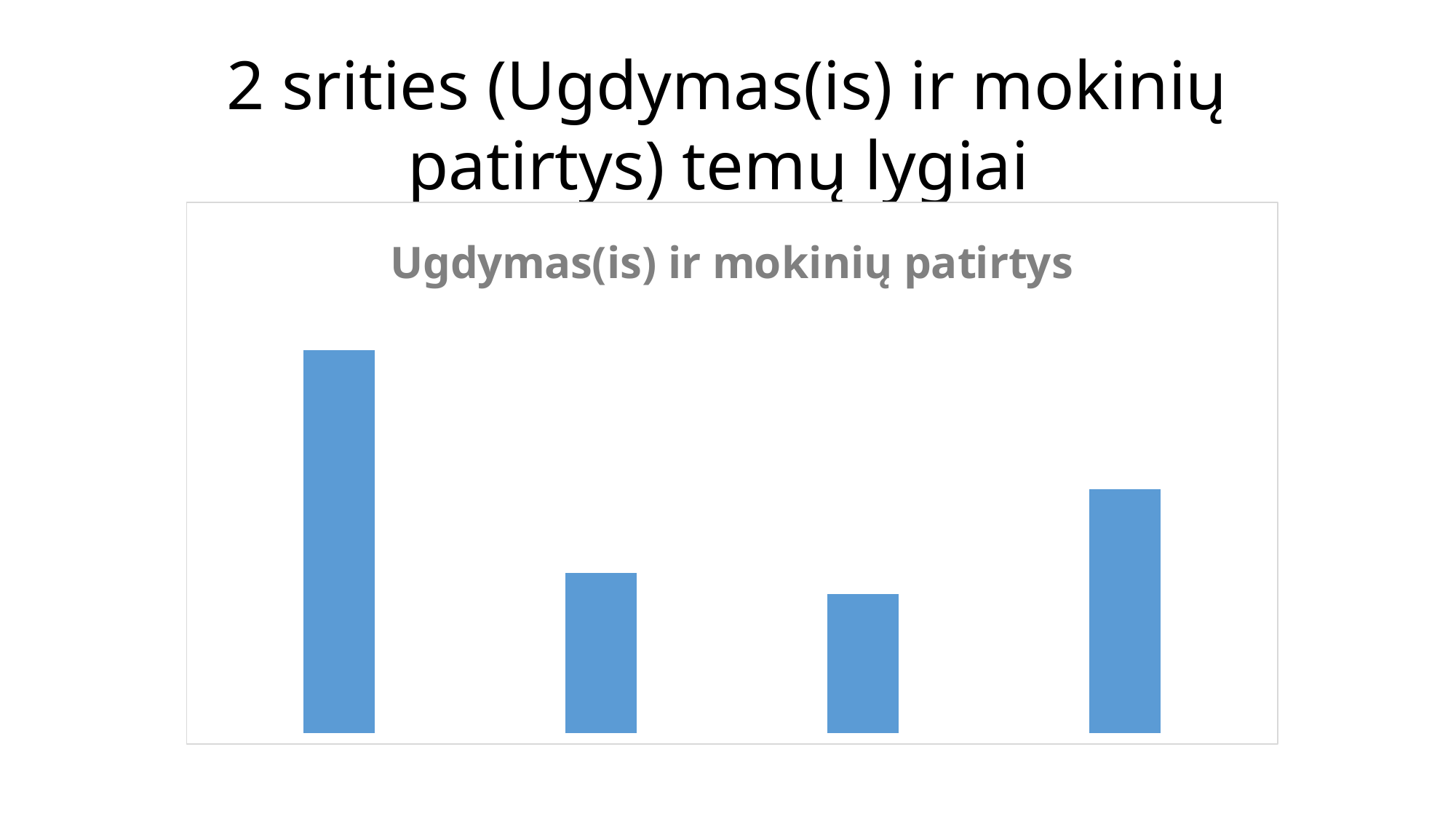
Which bar is the tallest in the chart, counting from the left? the first (leftmost) bar How many bars does the chart show? 4 Which bar is the shortest in the chart, counting from the left? the third bar What kind of chart is shown on the slide? bar chart Which is taller, the first bar or the fourth bar? the first bar What is the title of the chart? Ugdymas(is) ir mokinių patirtys What colour are the bars in the chart? blue Which is taller, the second bar or the fourth bar? the fourth bar Which is taller, the second bar or the third bar? the second bar